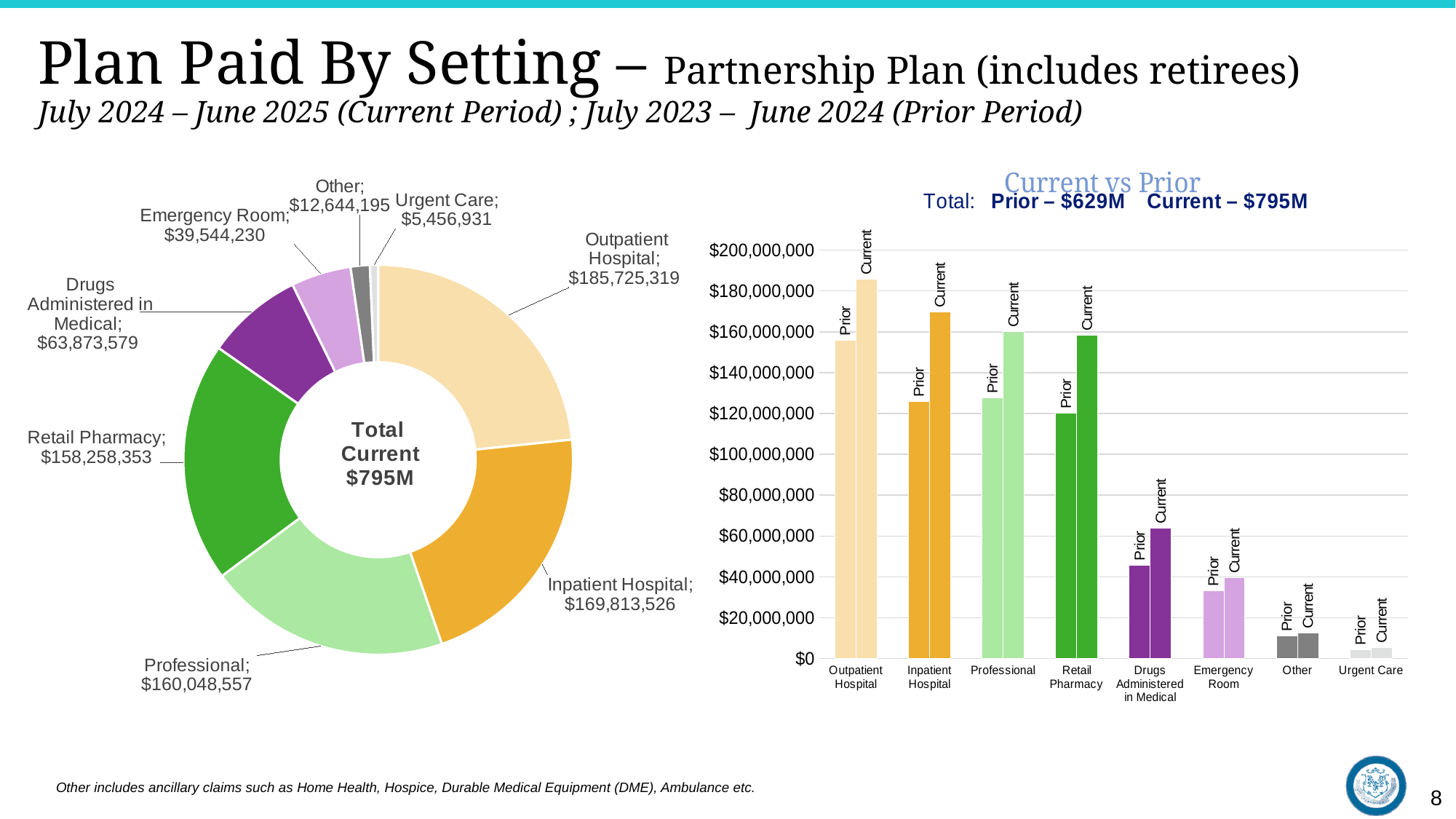
In the donut chart on the left, what total is shown in the centre? Total Current $795M In the Current vs Prior chart on the right, how many settings are shown on the x axis? 8 In the Current vs Prior chart on the right, is the Prior value for Inpatient Hospital greater or less than $140,000,000? less In the donut chart on the left, which is larger: Professional or Retail Pharmacy? Professional In the donut chart on the left, what is the value for Inpatient Hospital? $169,813,526 In the Current vs Prior chart on the right, is the Prior value for Emergency Room greater or less than $40,000,000? less In the Current vs Prior chart on the right, is the Prior value for Outpatient Hospital greater or less than $140,000,000? greater In the donut chart on the left, what is the difference between Outpatient Hospital and Inpatient Hospital? $15,911,793 In the donut chart on the left, which setting has the largest value? Outpatient Hospital In the donut chart on the left, what is the value for Emergency Room? $39,544,230 What kind of chart is the Current vs Prior chart on the right? bar chart In the donut chart on the left, which setting has the smallest value? Urgent Care